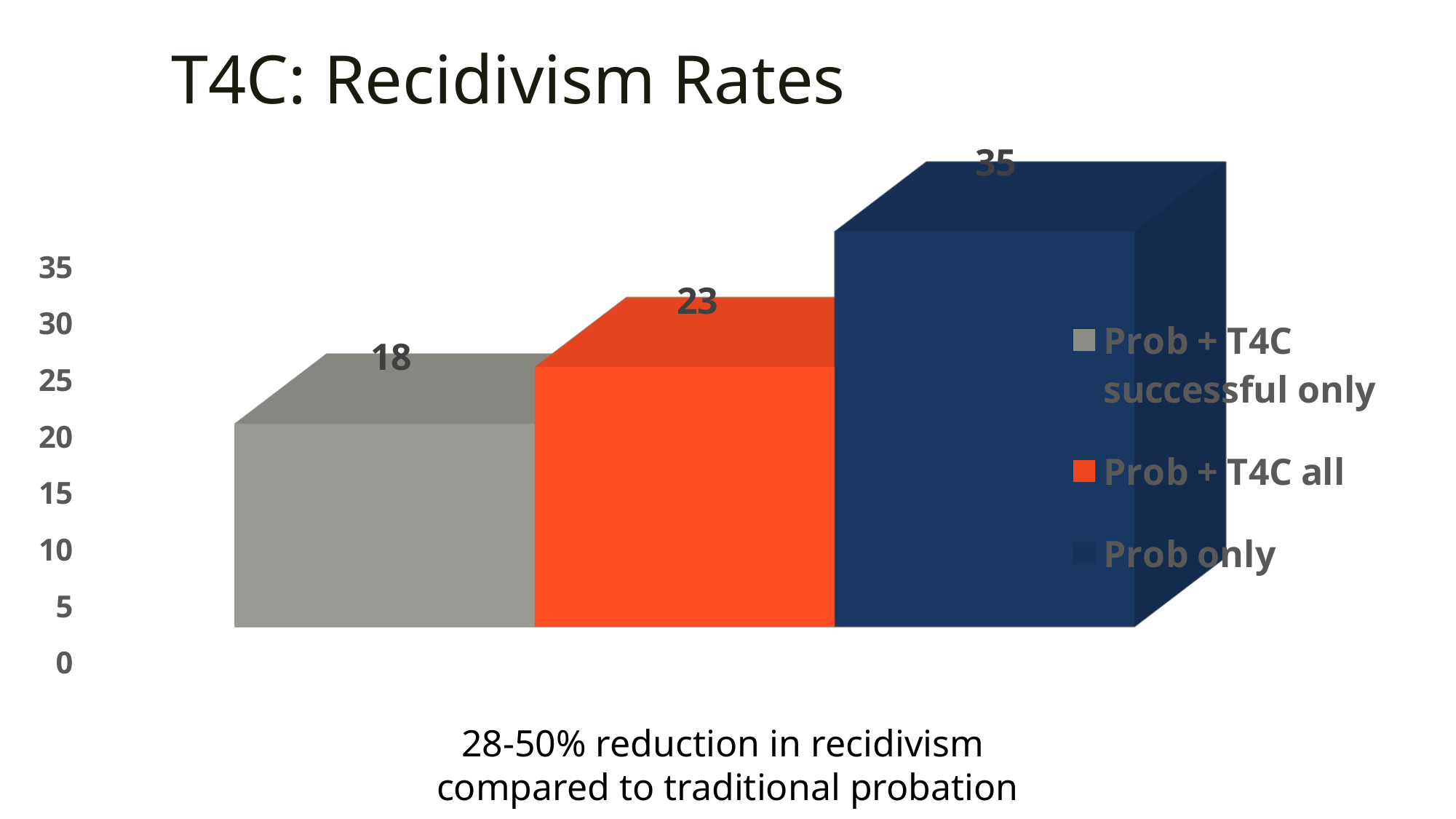
What is the difference between the values for Prob + T4C all and Prob + T4C successful only? 5 What colour is the bar for Prob + T4C all? orange What is the difference between the values for Prob only and Prob + T4C successful only? 17 What is the title of the chart? T4C: Recidivism Rates Which is larger, the value for Prob + T4C all or the value for Prob only? Prob only How many series does the legend list? 3 Which series has the highest value? Prob only What is the value for Prob + T4C successful only? 18 What kind of chart is shown on the slide? bar chart What is the value for Prob only? 35 Which series has the lowest value? Prob + T4C successful only What is the value for Prob + T4C all? 23